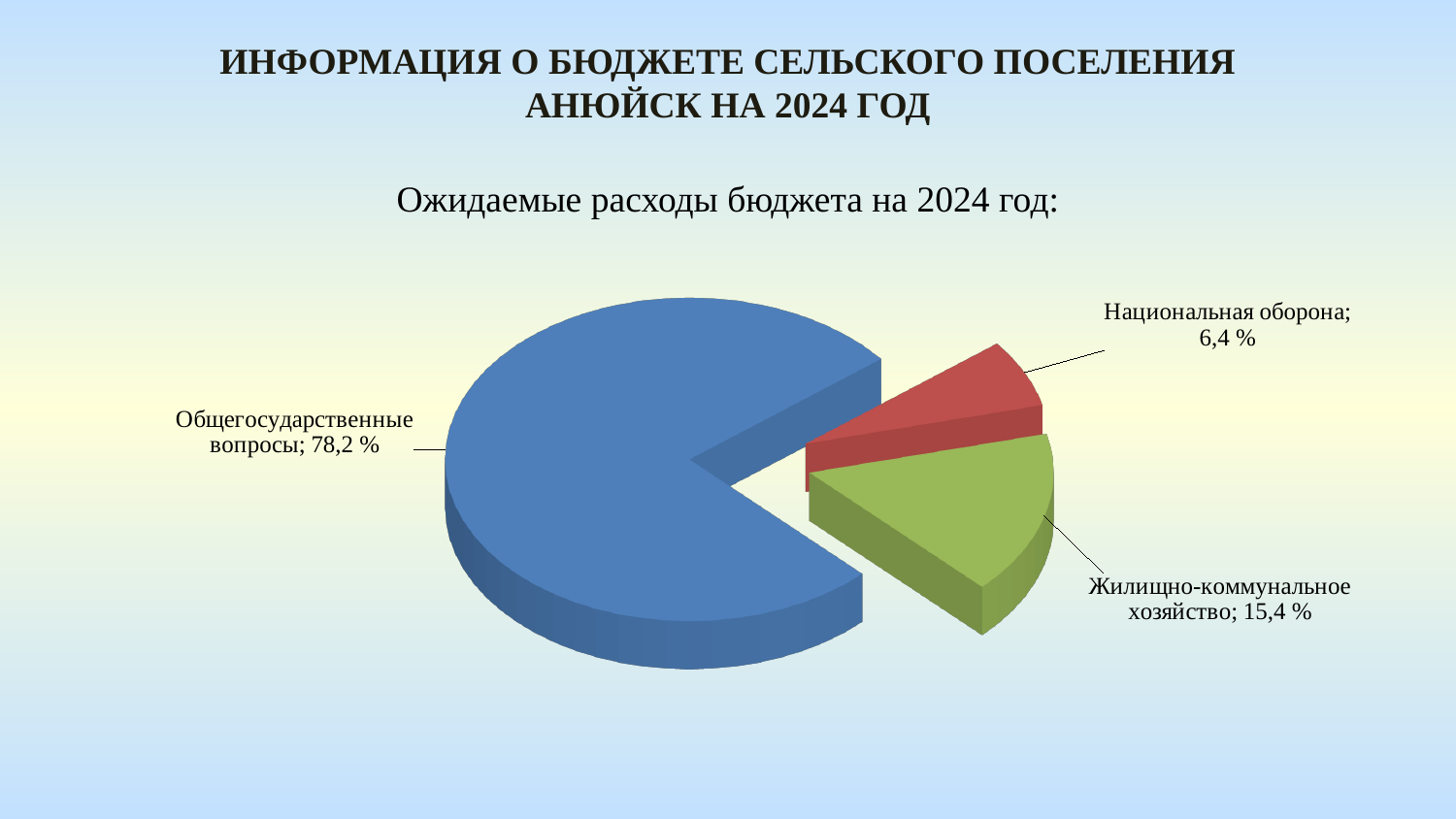
Which category has the smallest slice of the pie? Национальная оборона Which is larger: the share of Жилищно-коммунальное хозяйство or the share of Национальная оборона? Жилищно-коммунальное хозяйство What is the difference between the shares of Общегосударственные вопросы and Жилищно-коммунальное хозяйство? 62,8 % What is the title of the chart? Ожидаемые расходы бюджета на 2024 год: How many categories are shown in the pie chart? 3 Which category has the largest slice of the pie? Общегосударственные вопросы What is the value shown for Национальная оборона? 6,4 % What share of the pie does Общегосударственные вопросы have? 78,2 % What kind of chart is shown on the slide? Pie chart What is the value shown for Жилищно-коммунальное хозяйство? 15,4 % What is the difference between the shares of Жилищно-коммунальное хозяйство and Национальная оборона? 9,0 % What colour is the slice for Национальная оборона? Red